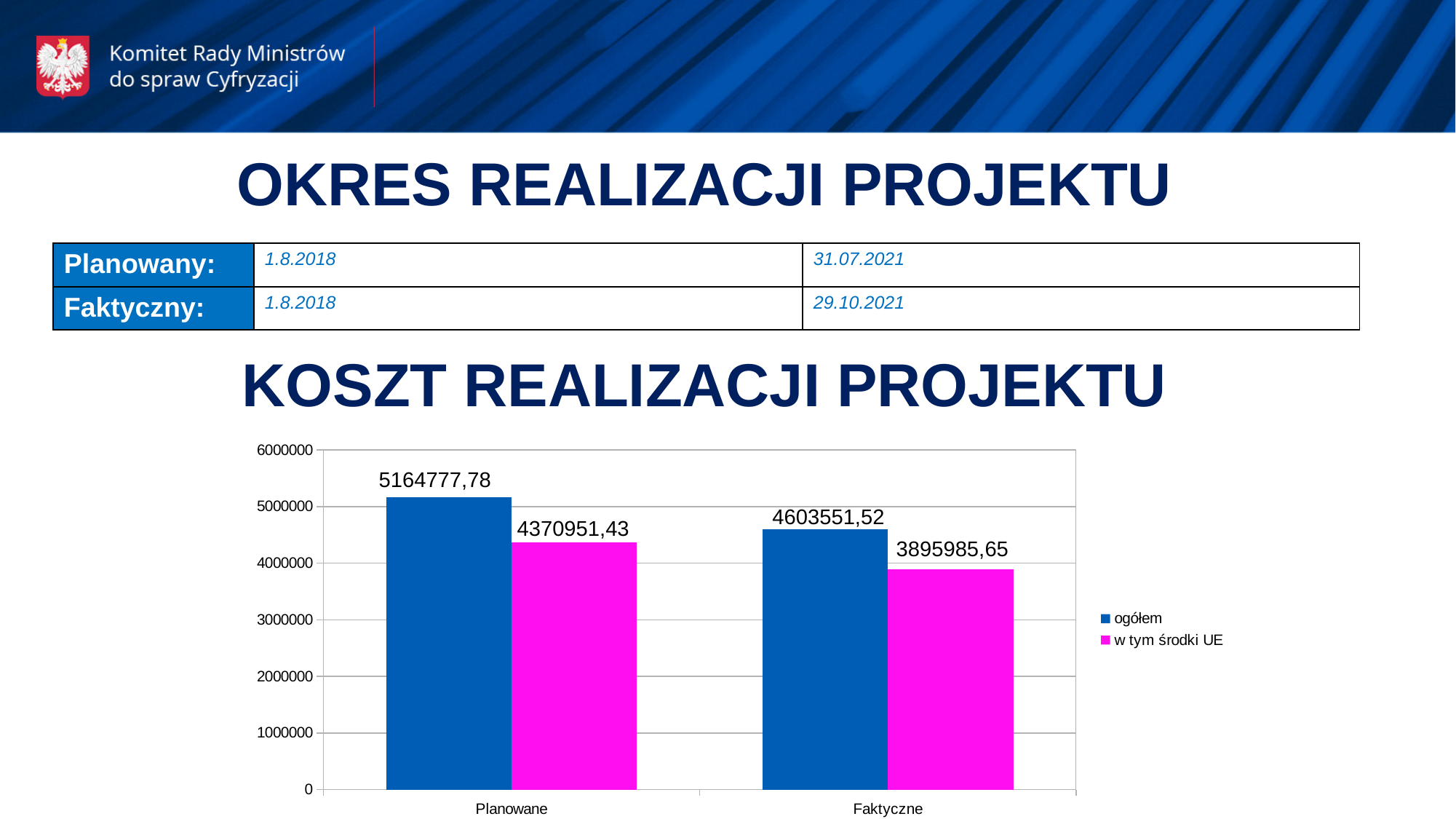
What is the difference between ogółem and w tym środki UE for Faktyczne? 707565,87 What is the value of ogółem for Faktyczne? 4603551,52 What is the value of ogółem for Planowane? 5164777,78 Which bar in the chart has the highest value? Planowane, ogółem What is the value of w tym środki UE for Planowane? 4370951,43 How many categories are shown on the x axis of the chart? 2 Which is larger: w tym środki UE for Planowane or ogółem for Faktyczne? ogółem for Faktyczne What is the difference between the ogółem values for Planowane and Faktyczne? 561226,26 What is the value of w tym środki UE for Faktyczne? 3895985,65 What type of chart is shown under the heading KOSZT REALIZACJI PROJEKTU? bar chart How many series does the chart legend list? 2 Which bar in the chart has the lowest value? Faktyczne, w tym środki UE